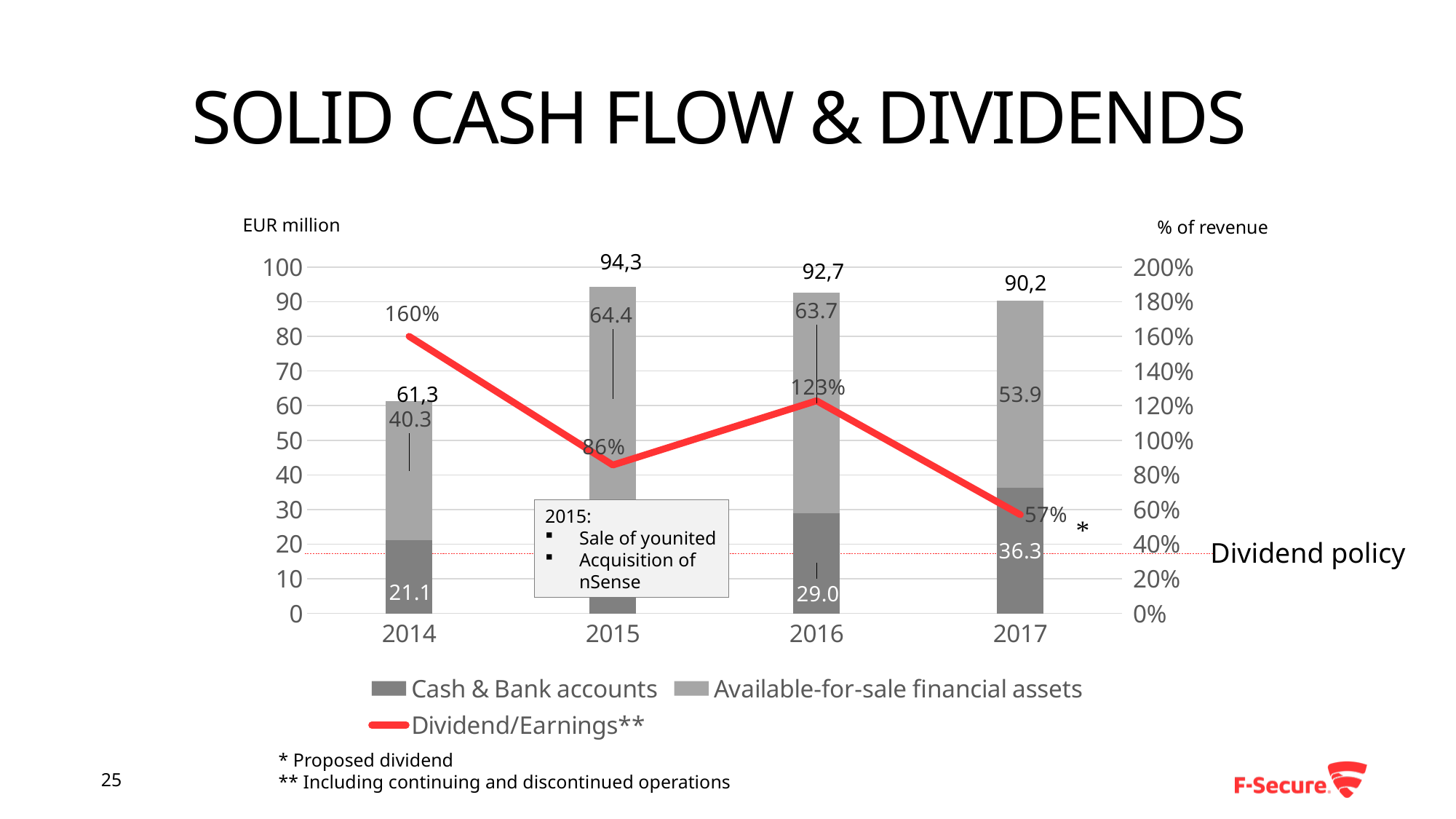
Is the Dividend/Earnings** value for 2016 greater or less than 100%? greater How many series does the legend list? 3 What unit is shown on the left axis? EUR million What is the difference between the Cash & Bank accounts values for 2017 and 2016? 7.3 What is the Cash & Bank accounts value for 2014? 21.1 What is the Available-for-sale financial assets value for 2016? 63.7 Is the Available-for-sale financial assets value larger in 2015 or in 2017? 2015 Which year has the highest Dividend/Earnings** value? 2014 What is the total of the stacked bar for 2015? 94,3 What is the Dividend/Earnings** value for 2017? 57% Which year has the lowest stacked bar total? 2014 How many years are shown on the x axis? 4